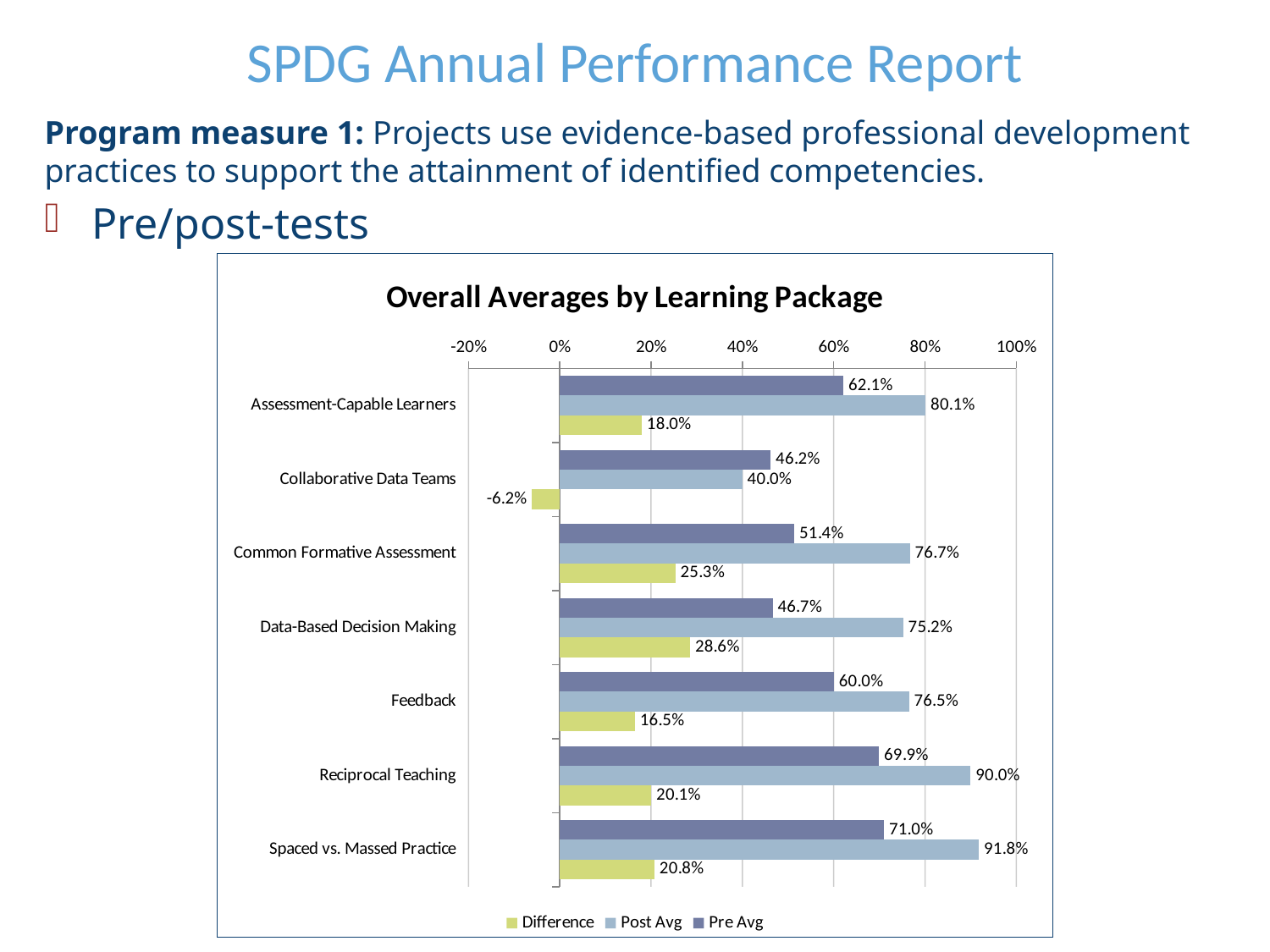
What is the Pre Avg value for Collaborative Data Teams? 46.2% Which is larger for Common Formative Assessment, the Pre Avg or the Post Avg? Post Avg What is the difference between the Post Avg and Pre Avg for Feedback? 16.5% How many series does the legend list? 3 Which learning package has the lowest Difference value? Collaborative Data Teams How many learning packages are shown on the chart? 7 What kind of chart is shown? Bar chart Which learning package has the highest Post Avg? Spaced vs. Massed Practice What is the title of the chart? Overall Averages by Learning Package Is the Pre Avg for Assessment-Capable Learners greater or less than 60%? greater What is the Post Avg value for Reciprocal Teaching? 90.0% What is the Difference value for Data-Based Decision Making? 28.6%